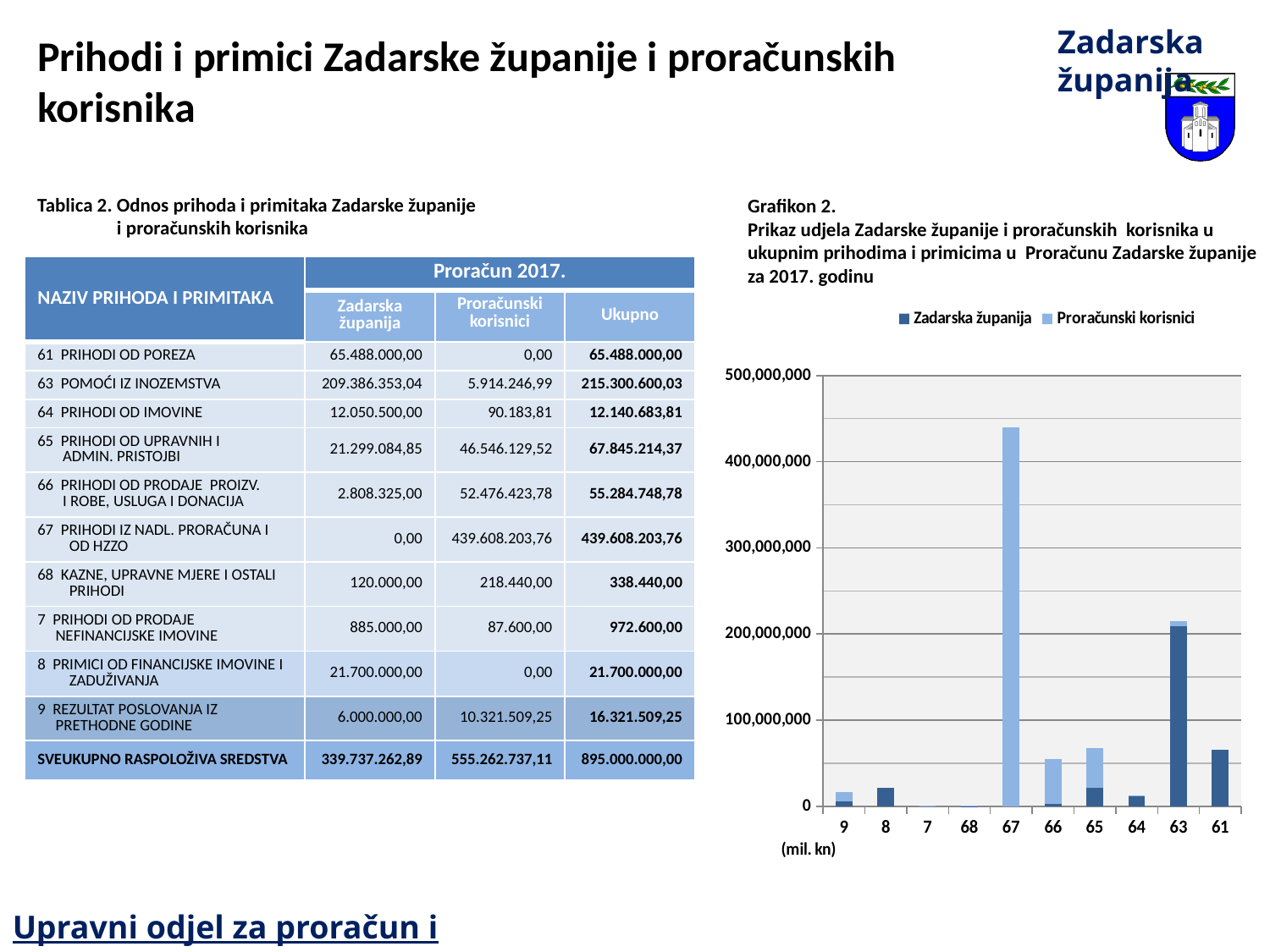
What kind of chart is Grafikon 2? bar chart In Grafikon 2, is the total bar for category 63 greater or less than 200,000,000? greater In Grafikon 2, which bar is taller: category 67 or category 63? 67 In Grafikon 2, is the total bar for category 67 greater or less than 400,000,000? greater What are the two legend entries in Grafikon 2? Zadarska županija, Proračunski korisnici How many categories are shown on the x axis of Grafikon 2? 10 In Grafikon 2, which bar is taller: category 65 or category 64? 65 In Grafikon 2, which category has the tallest bar? 67 In Grafikon 2, is the total bar for category 65 greater or less than 100,000,000? less How many series does the legend of Grafikon 2 list? 2 What unit label is shown below the x axis of Grafikon 2? (mil. kn)